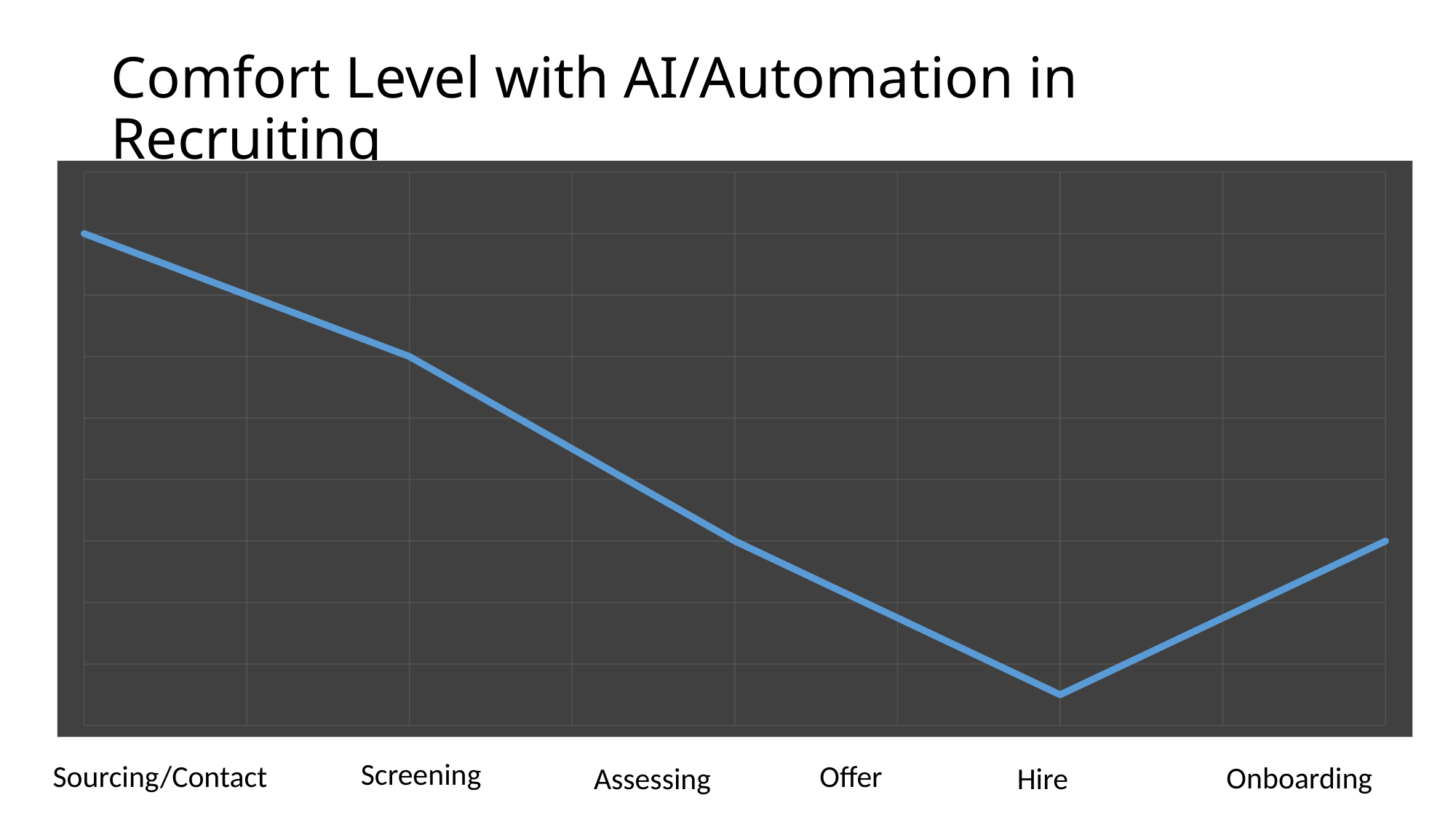
Which has the larger value, Hire or Onboarding? Onboarding Do the values rise or fall from Sourcing/Contact to Hire? Fall What is the title of the slide? Comfort Level with AI/Automation in Recruiting Which category has the lowest value? Hire How many categories are plotted along the x axis? 6 What kind of chart is shown on the slide? Line chart Which has the larger value, Sourcing/Contact or Screening? Sourcing/Contact What is the last category on the x axis? Onboarding Which has the larger value, Screening or Offer? Screening Do the values rise or fall from Hire to Onboarding? Rise Which category has the highest value? Sourcing/Contact